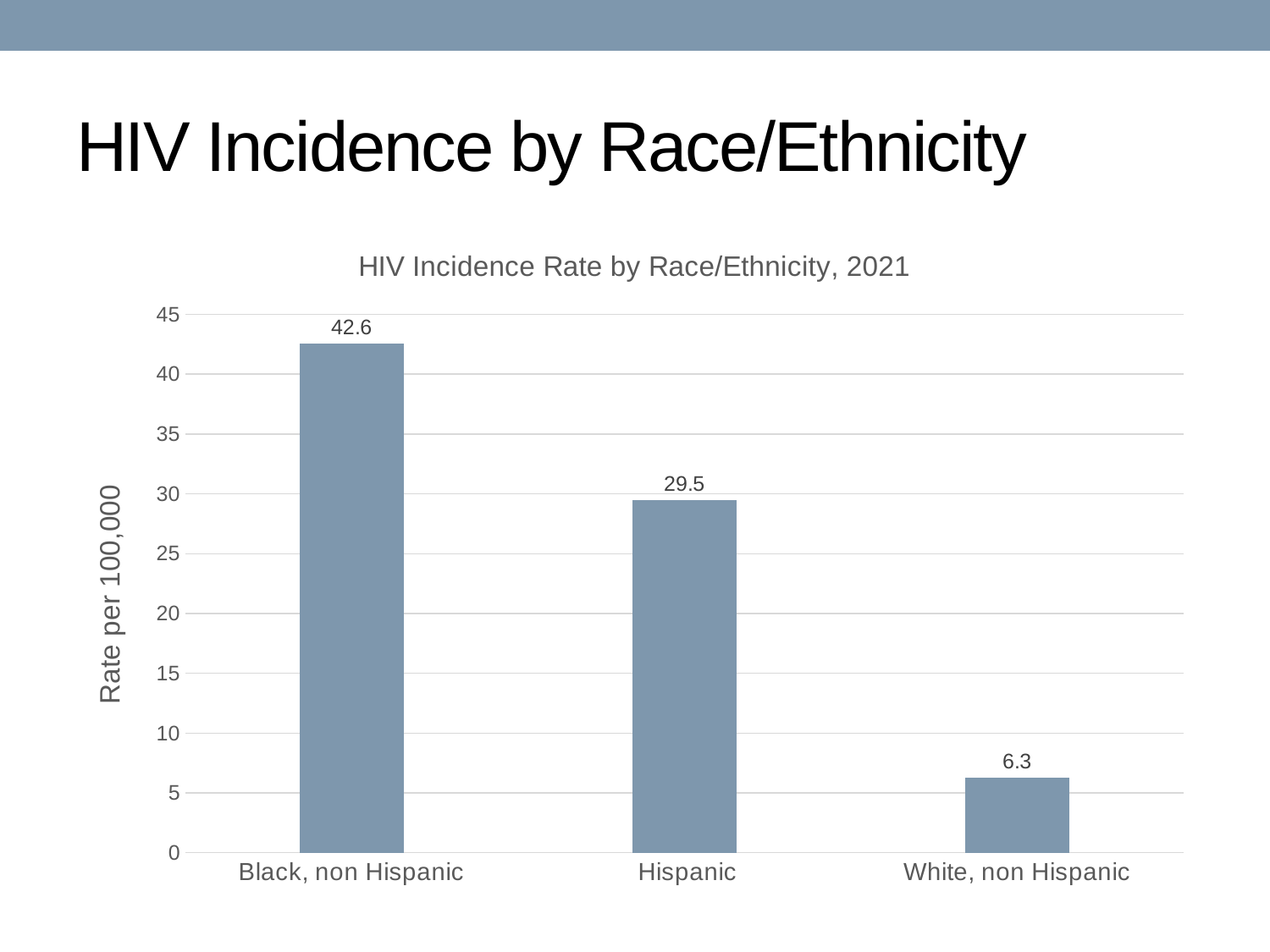
Which race/ethnicity group has the lowest HIV incidence rate? White, non Hispanic What is the HIV incidence rate for White, non Hispanic? 6.3 What is the difference between the HIV incidence rates for Hispanic and White, non Hispanic? 23.2 Is the HIV incidence rate for Hispanic greater or less than 30? less Which has a higher HIV incidence rate, Hispanic or White, non Hispanic? Hispanic Which race/ethnicity group has the highest HIV incidence rate? Black, non Hispanic What is the title of the chart? HIV Incidence Rate by Race/Ethnicity, 2021 What is the HIV incidence rate for Hispanic? 29.5 What is the difference between the HIV incidence rates for Black, non Hispanic and Hispanic? 13.1 How many race/ethnicity categories are shown in the chart? 3 What is the HIV incidence rate for Black, non Hispanic? 42.6 What kind of chart is shown on the slide? Bar chart